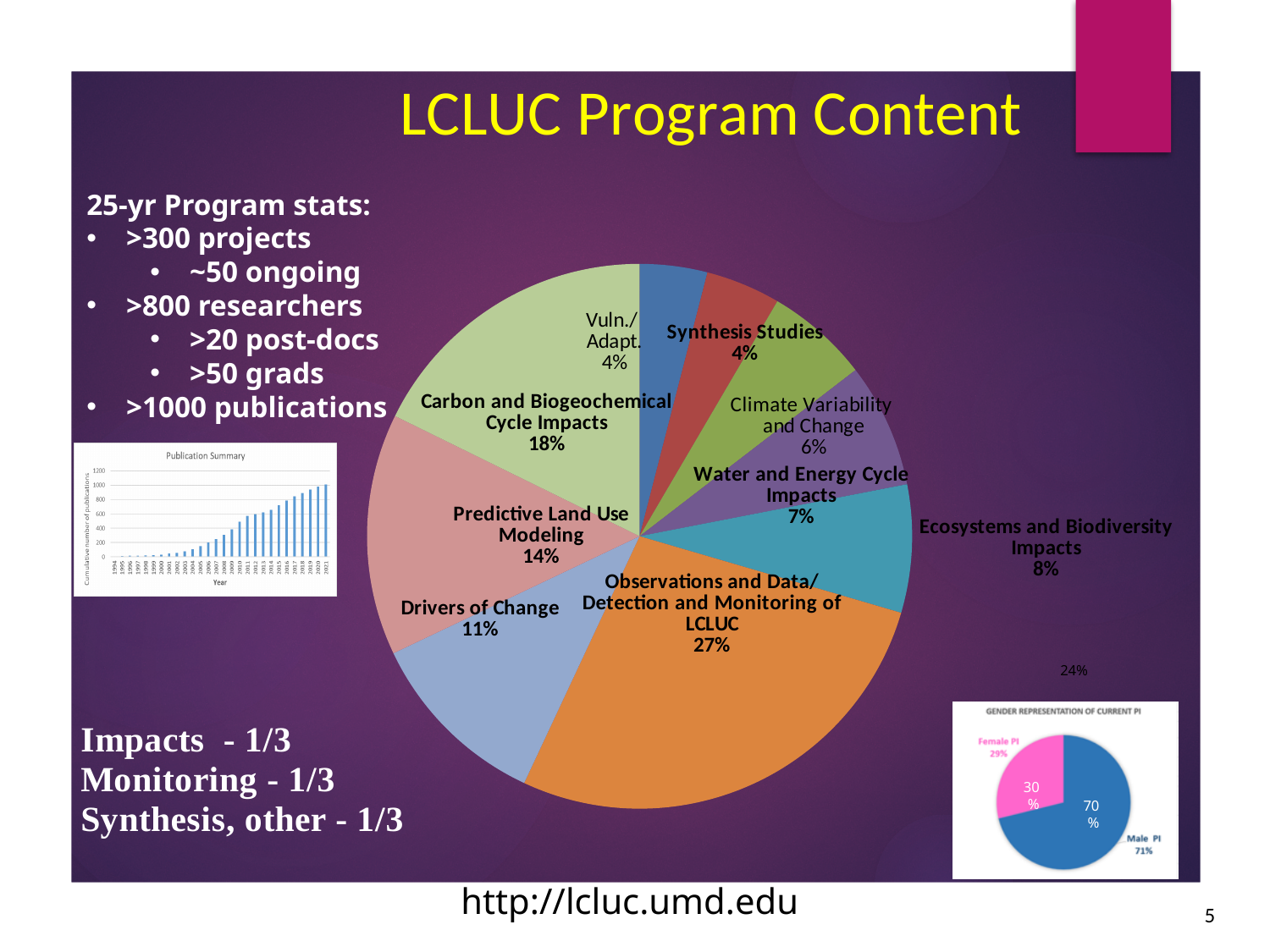
In the Publication Summary chart, do the values rise or fall from 1994 to 2021? Rise In the large pie chart, what share is labelled for Observations and Data/Detection and Monitoring of LCLUC? 27% In the Gender Representation of Current PI chart, which slice is larger, Male PI or Female PI? Male PI In the large pie chart, what share is labelled for Predictive Land Use Modeling? 14% In the large pie chart, what is the difference in percentage points between Carbon and Biogeochemical Cycle Impacts and Climate Variability and Change? 12 What kind of chart is the Publication Summary chart on the left of the slide? Bar chart In the large pie chart, which is larger, Drivers of Change or Water and Energy Cycle Impacts? Drivers of Change In the large pie chart, which category has the largest share? Observations and Data/Detection and Monitoring of LCLUC In the large pie chart, what share is labelled for Carbon and Biogeochemical Cycle Impacts? 18% What kind of chart is the large chart in the centre of the slide? Pie chart How many slices does the large pie chart have? 9 In the large pie chart, what share is labelled for Ecosystems and Biodiversity Impacts? 8%